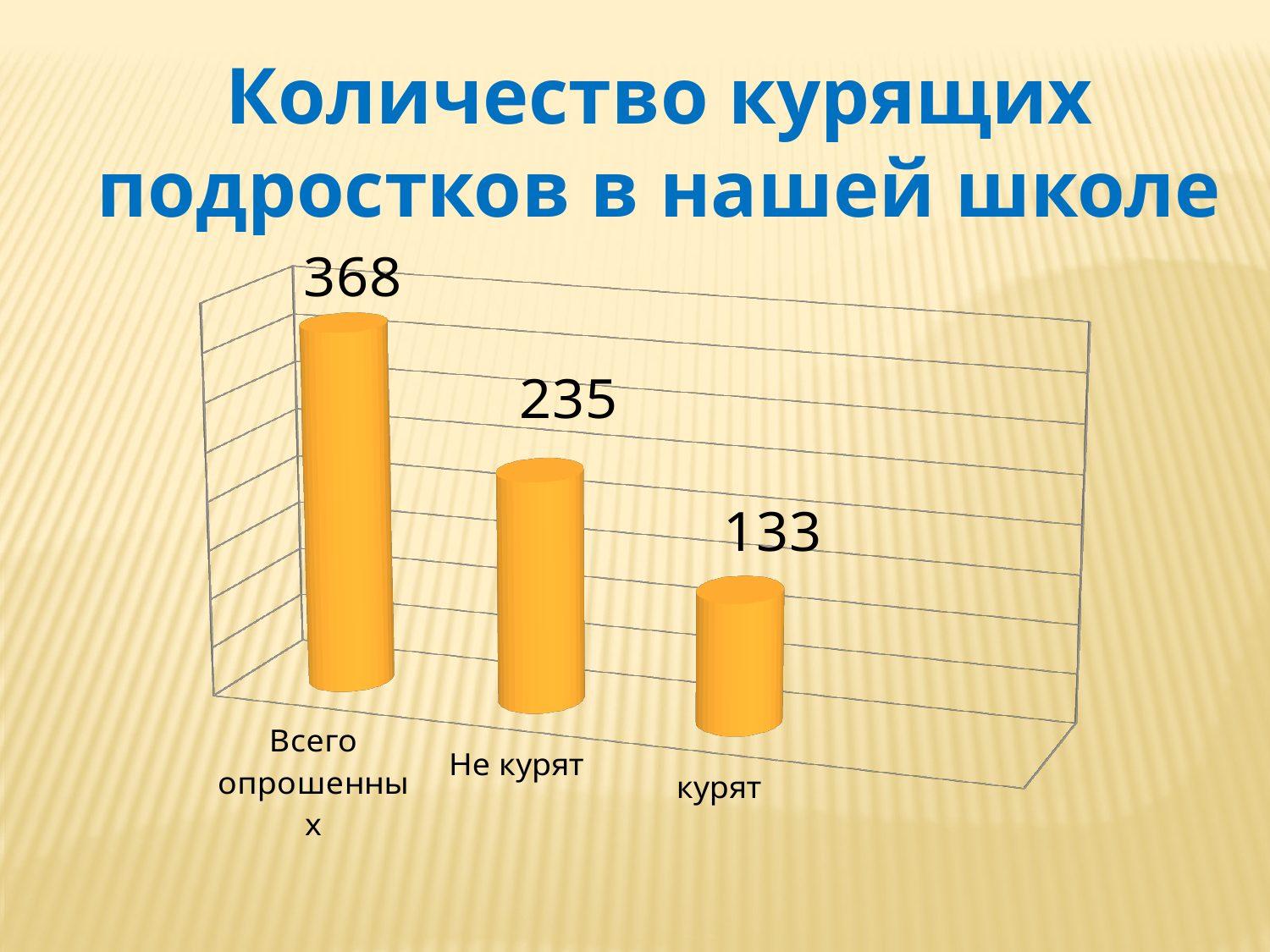
What is the difference between "Всего опрошенных" and "Не курят"? 133 What kind of chart is shown on the slide? bar chart What is the title of the slide? Количество курящих подростков в нашей школе Which category has the highest value? Всего опрошенных Do the values rise or fall from left to right along the x axis? fall What is the value for "курят"? 133 What is the value for "Не курят"? 235 Which category has the lowest value? курят What is the value for "Всего опрошенных"? 368 How many categories are shown in the chart? 3 What is the difference between "Не курят" and "курят"? 102 Which is larger, "Не курят" or "курят"? Не курят